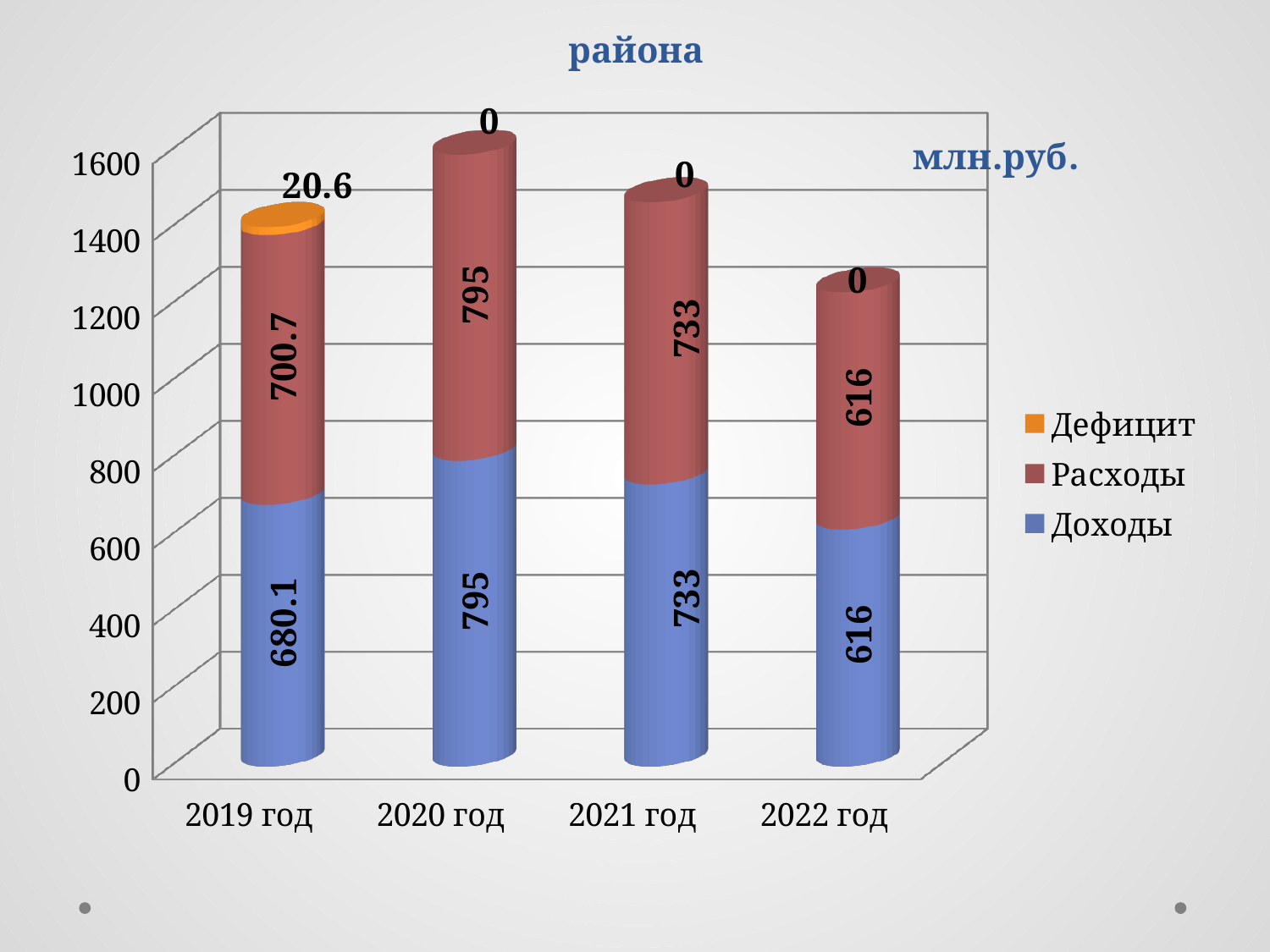
How many years are shown on the x axis? 4 What is the value of Расходы for 2022 год? 616 Which year has the lowest value of Расходы? 2022 год What is the total of the stacked bar for 2020 год? 1590 Which year has the highest value of Доходы? 2020 год What is the value of Дефицит for 2019 год? 20.6 What is the difference between Доходы in 2020 год and Доходы in 2022 год? 179 How many series does the legend list? 3 What is the value of Доходы for 2019 год? 680.1 What kind of chart is shown on the slide? Stacked bar chart Which is larger: Расходы in 2021 год or Расходы in 2022 год? Расходы in 2021 год What is the value of Расходы for 2019 год? 700.7